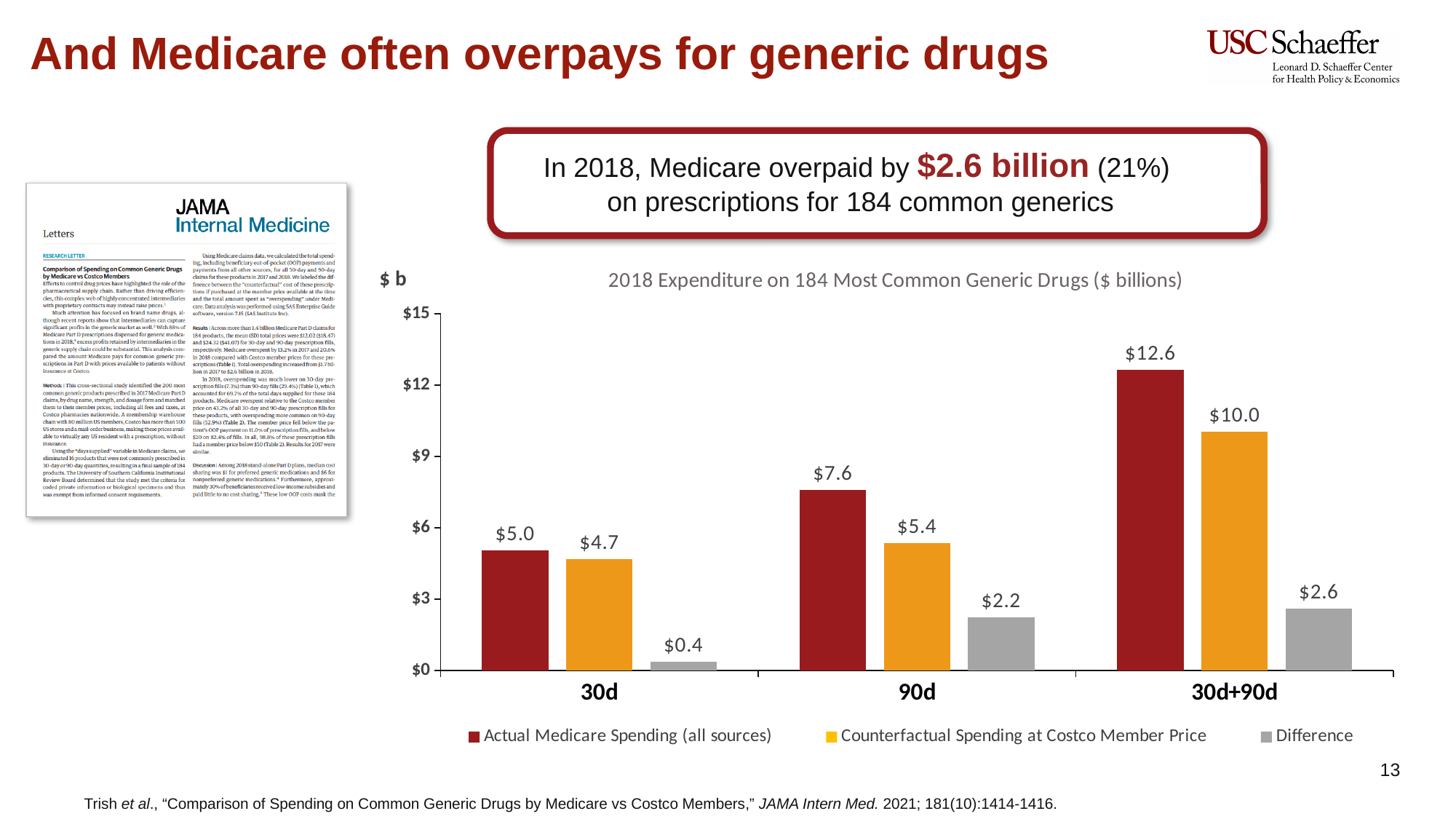
Is the Actual Medicare Spending (all sources) for 30d+90d greater or less than $12? greater How many categories are shown on the x axis? 3 Which category has the highest Actual Medicare Spending (all sources)? 30d+90d Which is larger for 30d: Actual Medicare Spending (all sources) or Counterfactual Spending at Costco Member Price? Actual Medicare Spending (all sources) What is the Counterfactual Spending at Costco Member Price for 30d+90d? $10.0 What is the Difference value for 30d? $0.4 What is the difference between Actual Medicare Spending and Counterfactual Spending at Costco Member Price for 90d? $2.2 Which category has the lowest Difference value? 30d What kind of chart is shown? bar chart What is the title of the chart? 2018 Expenditure on 184 Most Common Generic Drugs ($ billions) What is the Actual Medicare Spending (all sources) for 90d? $7.6 How many series does the legend list? 3